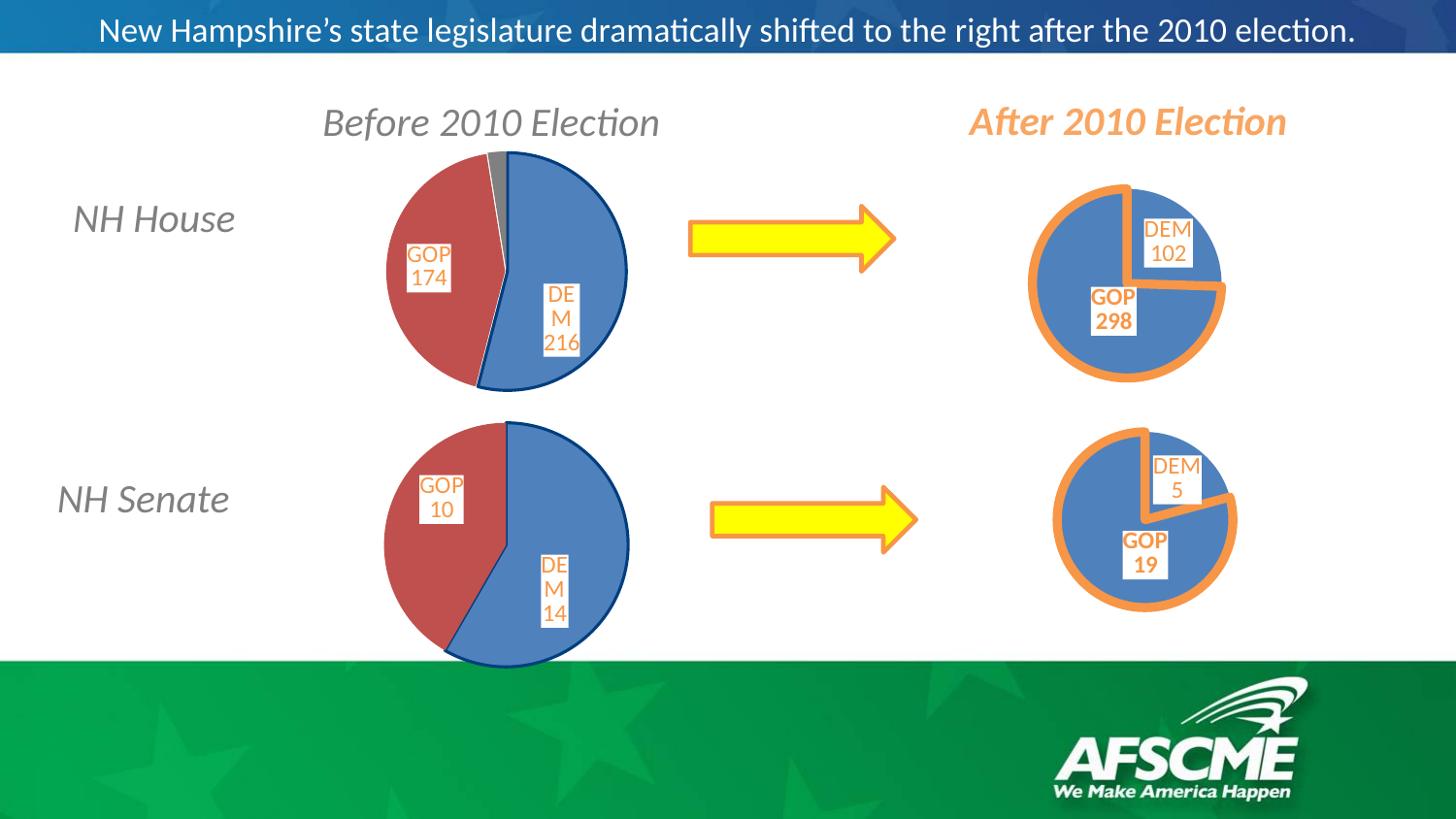
In the NH House 'Before 2010 Election' pie chart, what is the value for GOP? 174 In the NH House 'After 2010 Election' pie chart, which party has the smaller slice? DEM In the NH Senate 'Before 2010 Election' pie chart, which party has the larger slice? DEM What kind of chart is used for the NH Senate 'Before 2010 Election' data? pie chart How many pie charts are shown on the slide? 4 In the NH Senate 'Before 2010 Election' pie chart, is the GOP value larger or smaller than the DEM value? smaller In the NH House 'After 2010 Election' pie chart, what is the difference between the GOP and DEM values? 196 In the NH Senate 'After 2010 Election' pie chart, what is the difference between the GOP and DEM values? 14 In the NH Senate 'After 2010 Election' pie chart, what share of the total does GOP represent, to one decimal place? 79.2% In the NH House 'After 2010 Election' pie chart, what is the value for GOP? 298 In the NH Senate 'After 2010 Election' pie chart, what is the value for DEM? 5 In the NH House 'Before 2010 Election' pie chart, what is the value for DEM? 216